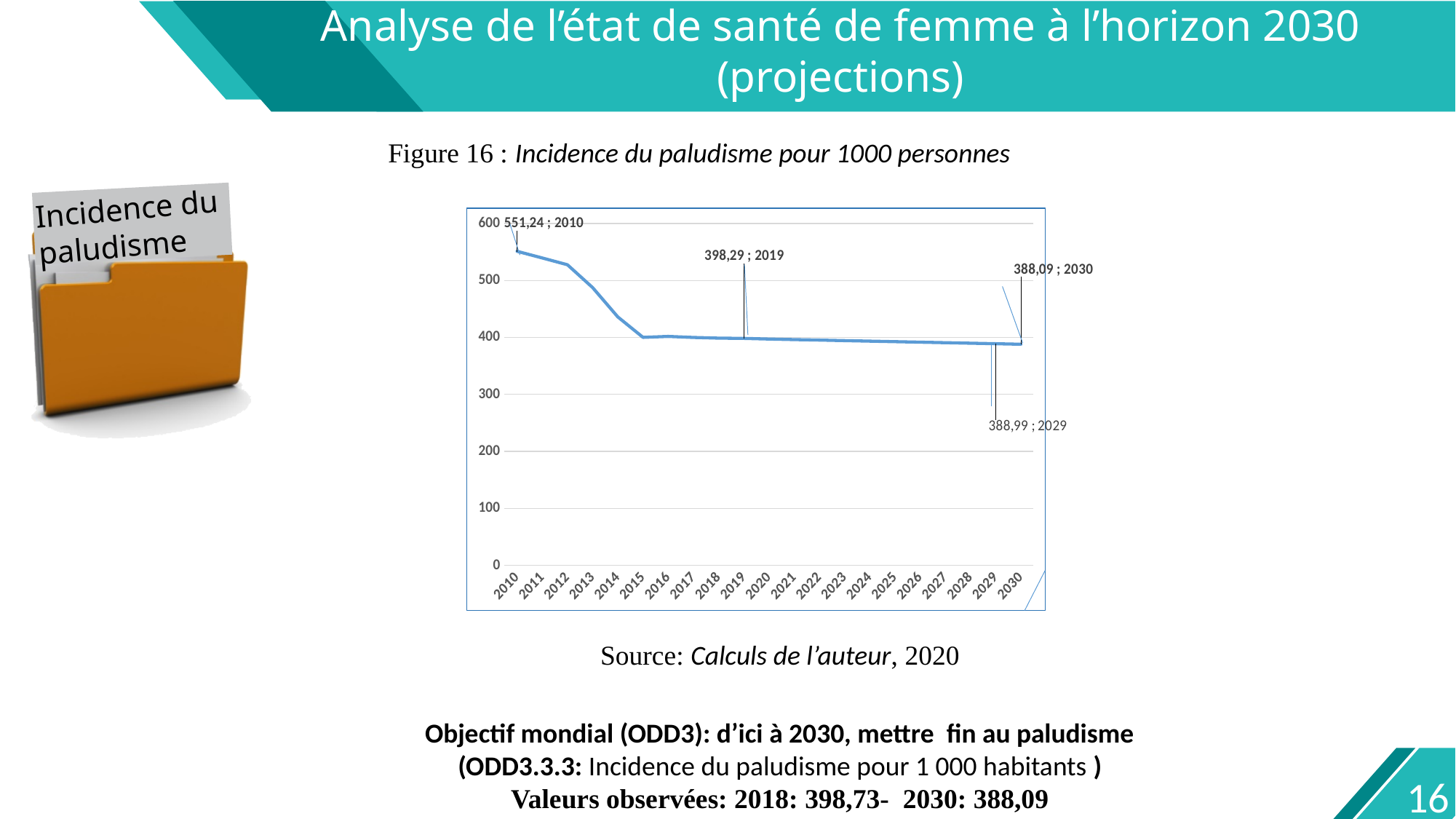
Do the values rise or fall from 2010 to 2030? fall Which is larger, the value for 2029 or the value for 2030? 2029 What is the malaria incidence value for 2010? 551,24 How many years are shown on the x axis? 21 What is the malaria incidence value for 2019? 398,29 Is the value for 2013 greater or less than 500? less Which year has the highest malaria incidence value? 2010 What is the difference between the 2019 value and the 2030 value? 10,20 What is the malaria incidence value for 2030? 388,09 What is the difference between the 2010 value and the 2030 value? 163,15 What type of chart is shown in Figure 16? line chart What is the malaria incidence value for 2029? 388,99